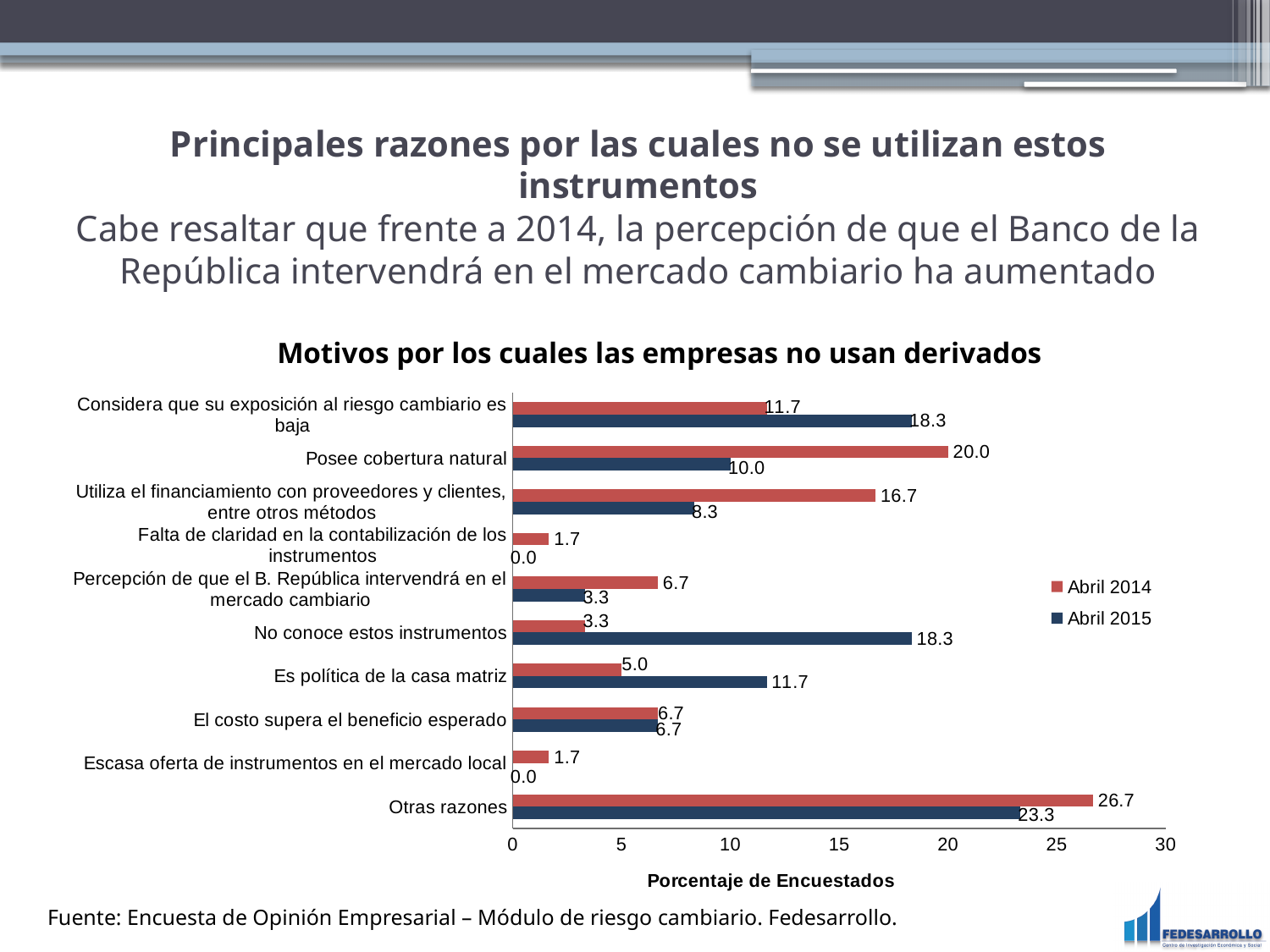
How many categories (reasons) are shown on the chart? 10 What is the difference between the Abril 2015 and Abril 2014 values for 'No conoce estos instrumentos'? 15.0 What is the Abril 2014 value for 'No conoce estos instrumentos'? 3.3 What type of chart is shown on the slide? Bar chart What is the label of the horizontal axis? Porcentaje de Encuestados Which category has the highest Abril 2015 value? Otras razones For 'Utiliza el financiamiento con proveedores y clientes, entre otros métodos', which is larger: the Abril 2014 value or the Abril 2015 value? Abril 2014 What is the Abril 2015 value for 'Posee cobertura natural'? 10.0 How many series does the legend list? 2 What is the Abril 2015 value for 'Es política de la casa matriz'? 11.7 Which category has the highest Abril 2014 value? Otras razones What is the title of the chart? Motivos por los cuales las empresas no usan derivados